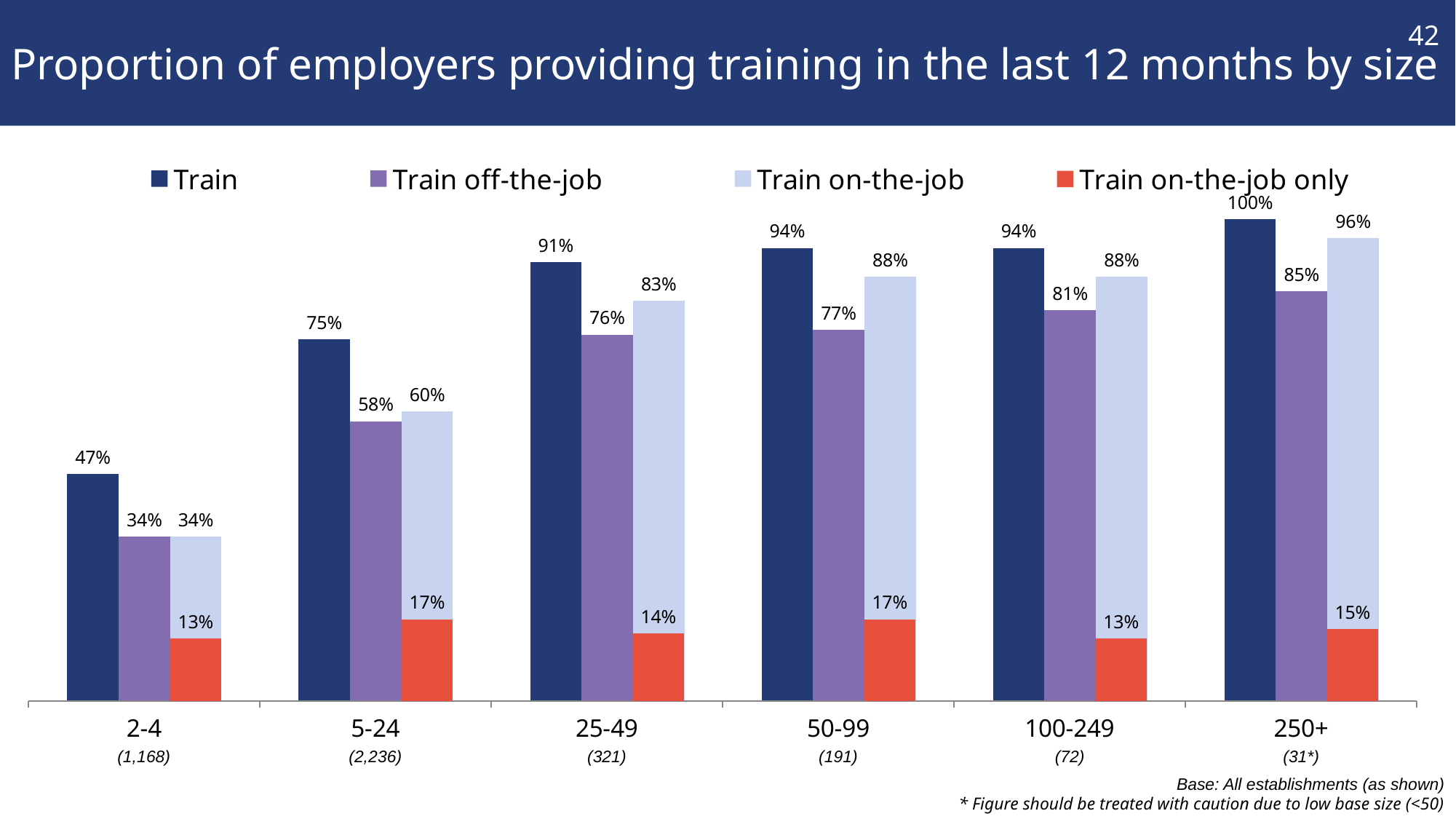
Which is larger: Train off-the-job for 50-99 or Train off-the-job for 25-49? 50-99 What is the difference between the Train value for 25-49 and the Train value for 5-24? 16 percentage points Which size band has the highest value for Train? 250+ Which size band has the lowest value for Train on-the-job? 2-4 What is the value for Train on-the-job only among employers with 5-24 employees? 17% How many series does the legend list? 4 How many size bands are shown on the x axis? 6 Does the Train value rise or fall as size band increases from 2-4 to 250+? Rise What is the base size shown for the 5-24 size band? 2,236 What percentage of employers with 2-4 employees train? 47% What is the value for Train off-the-job among employers with 100-249 employees? 81% What kind of chart is shown on the slide? Bar chart